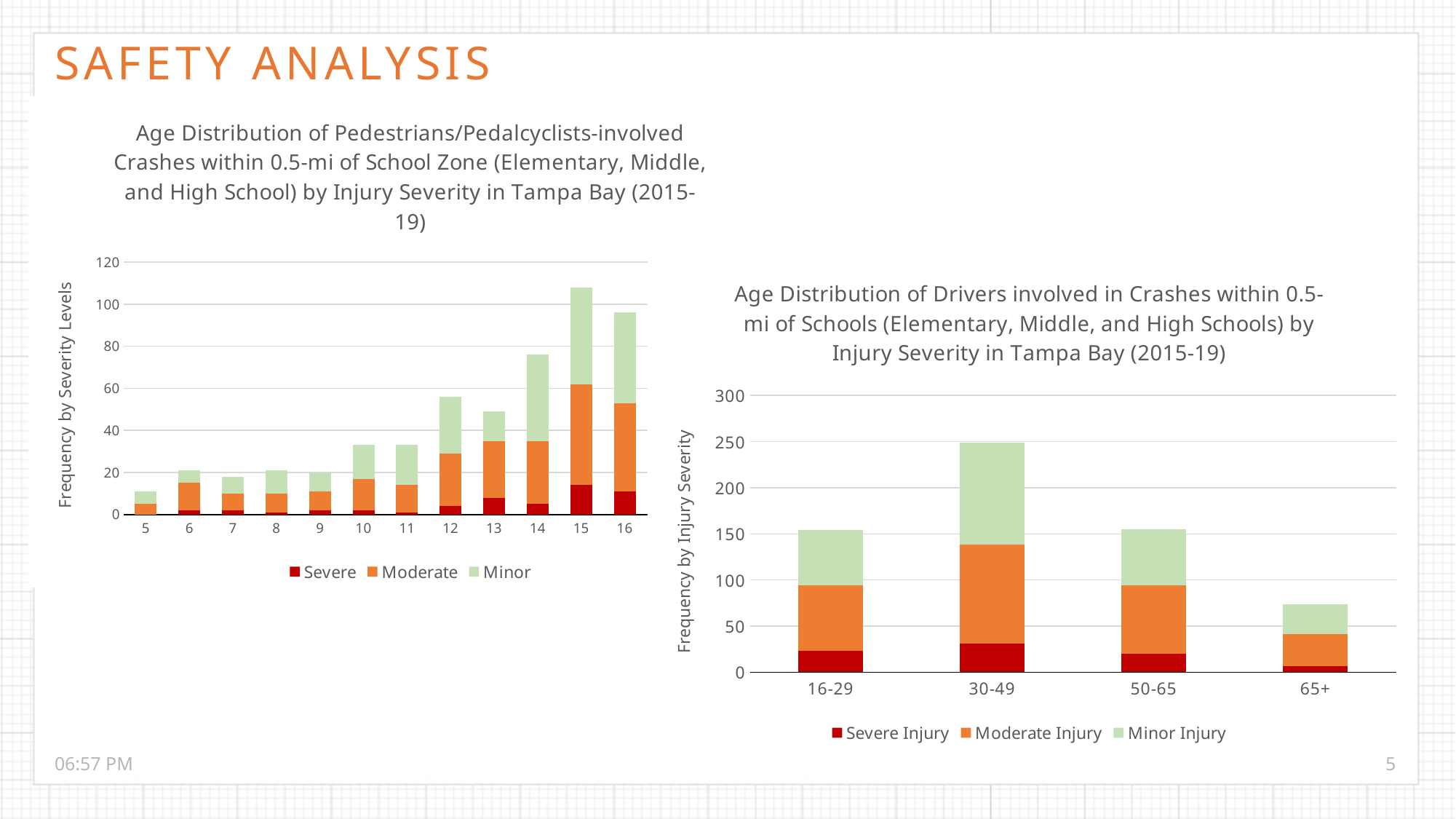
In the left chart (Pedestrians/Pedalcyclists), is the total bar for age 5 greater or less than 20? less In the left chart (Pedestrians/Pedalcyclists), how many age categories are shown on the x axis? 12 In the right chart (Drivers involved in Crashes), which age group has the lowest total bar? 65+ What kind of chart is the left chart, 'Age Distribution of Pedestrians/Pedalcyclists-involved Crashes'? Stacked bar chart In the right chart (Drivers involved in Crashes), is the total bar for 65+ greater or less than 100? less In the right chart (Drivers involved in Crashes), which age group has the highest total bar? 30-49 In the left chart (Pedestrians/Pedalcyclists), how many series does the legend list? 3 In the left chart (Pedestrians/Pedalcyclists), which age has the highest total bar? 15 In the right chart (Drivers involved in Crashes), what are the three legend entries? Severe Injury, Moderate Injury, Minor Injury In the right chart (Drivers involved in Crashes), how many age groups are shown on the x axis? 4 In the left chart (Pedestrians/Pedalcyclists), which age has the lowest total bar? 5 In the left chart (Pedestrians/Pedalcyclists), is the total bar for age 15 greater or less than 100? greater